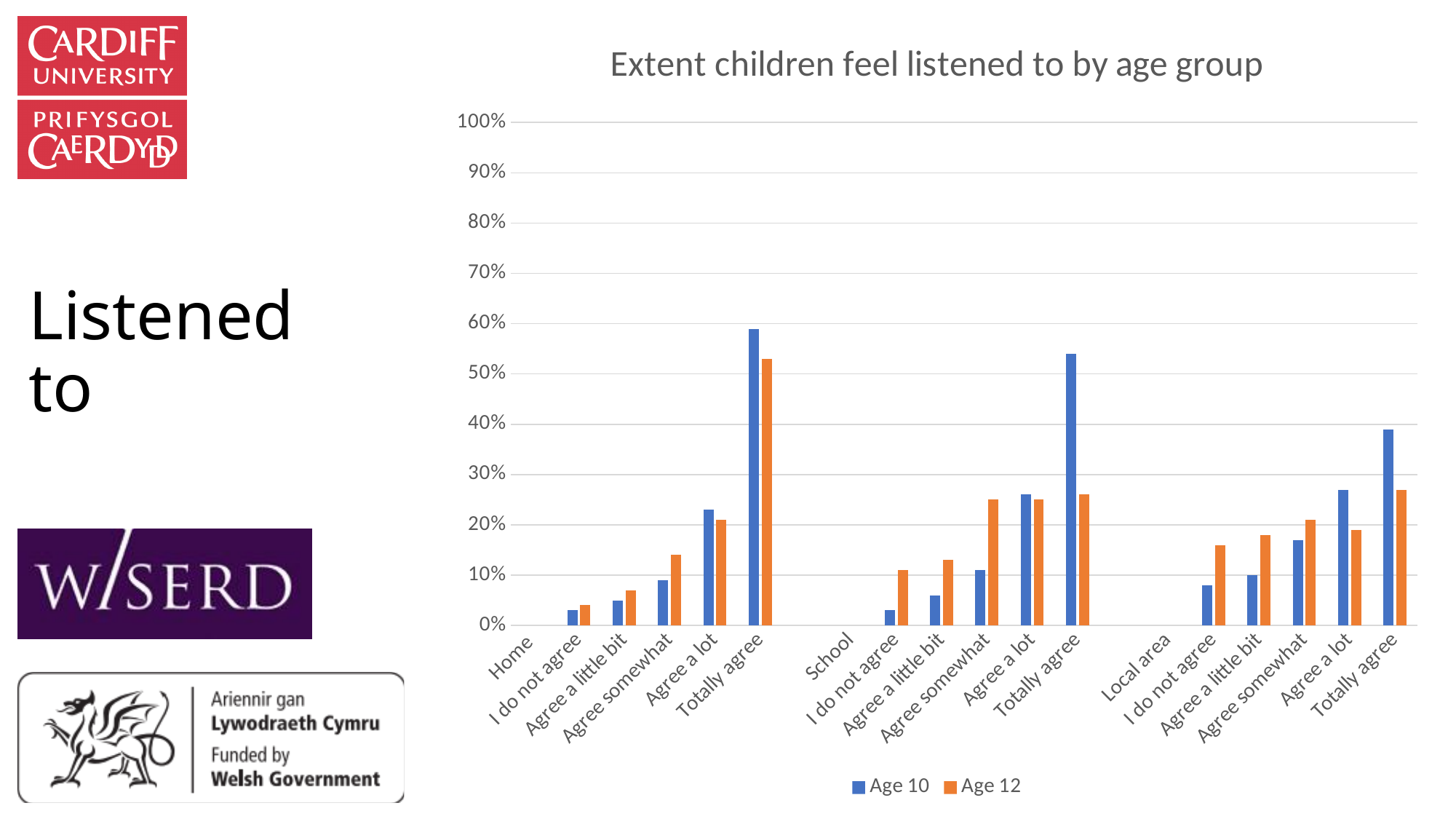
How many series does the legend list? 2 Is the Age 12 value for Totally agree under School greater or less than 30%? less What is the title of the chart? Extent children feel listened to by age group Is the Age 10 value for Totally agree under Home greater or less than 50%? greater What kind of chart is shown on the slide? Bar chart Is the Age 10 value for Totally agree under Local area greater or less than 30%? greater Among the Home response categories, which has the lowest Age 10 value? I do not agree For Agree somewhat under School, which is larger: Age 10 or Age 12? Age 12 Which bar is the tallest in the whole chart? Age 10, Totally agree (Home) What are the two series named in the legend? Age 10 and Age 12 For Totally agree under School, which is larger: Age 10 or Age 12? Age 10 For Agree a lot under Local area, which is larger: Age 10 or Age 12? Age 10